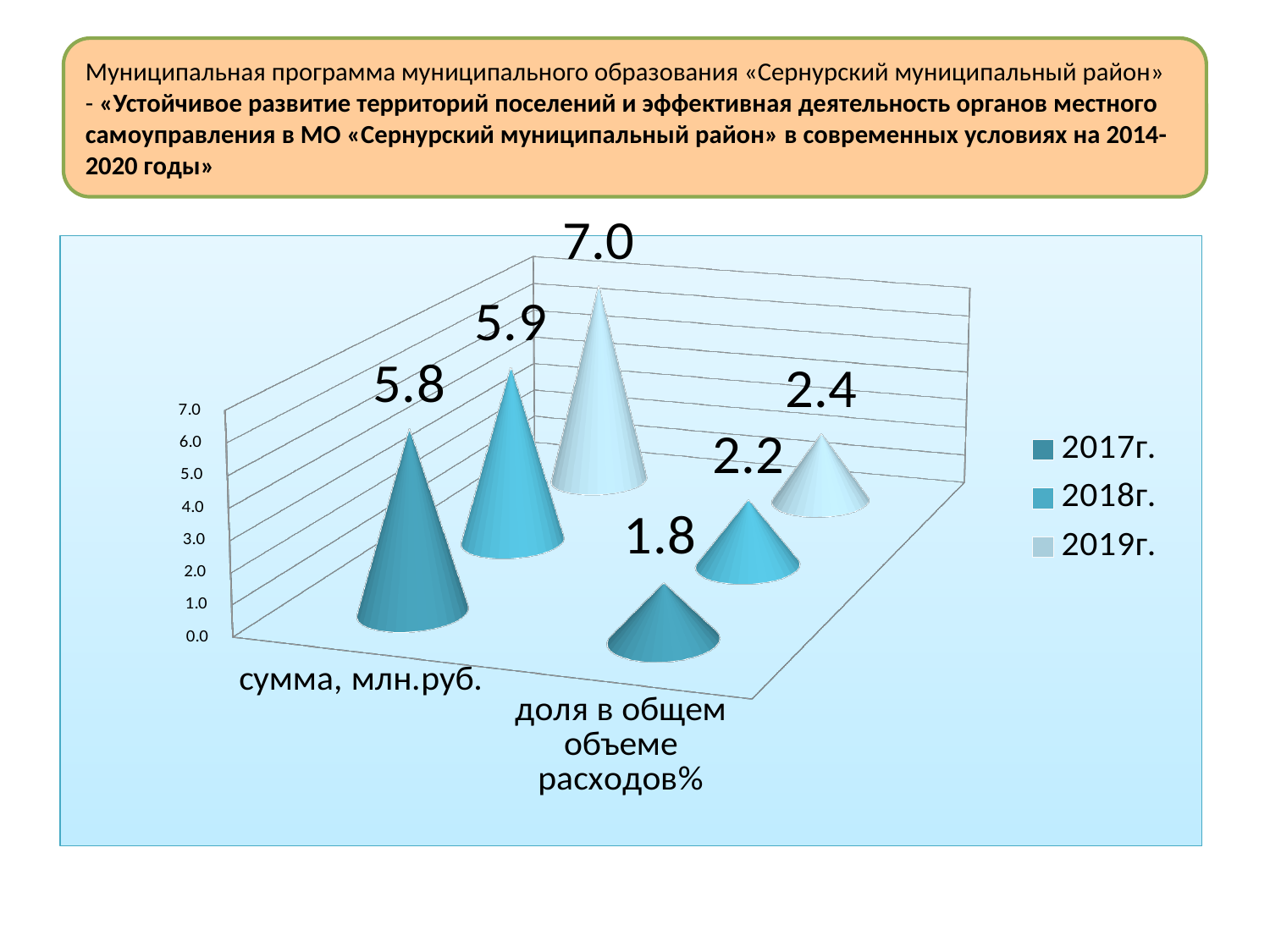
Which year has the highest value in the category «сумма, млн.руб.»? 2019г. Which is larger: the 2018г. value for «сумма, млн.руб.» or the 2018г. value for «доля в общем объеме расходов%»? сумма, млн.руб. What is the difference between the 2018г. and 2017г. values in the category «доля в общем объеме расходов%»? 0.4 What is the value for 2017г. in the category «доля в общем объеме расходов%»? 1.8 Do the values for «сумма, млн.руб.» rise or fall from 2017г. to 2019г.? rise Which year has the lowest value in the category «доля в общем объеме расходов%»? 2017г. How many series does the legend list? 3 What is the value for 2018г. in the category «сумма, млн.руб.»? 5.9 How many categories are shown on the x axis? 2 What is the difference between the 2019г. and 2017г. values in the category «сумма, млн.руб.»? 1.2 What is the value for 2019г. in the category «сумма, млн.руб.»? 7.0 What is the value for 2019г. in the category «доля в общем объеме расходов%»? 2.4